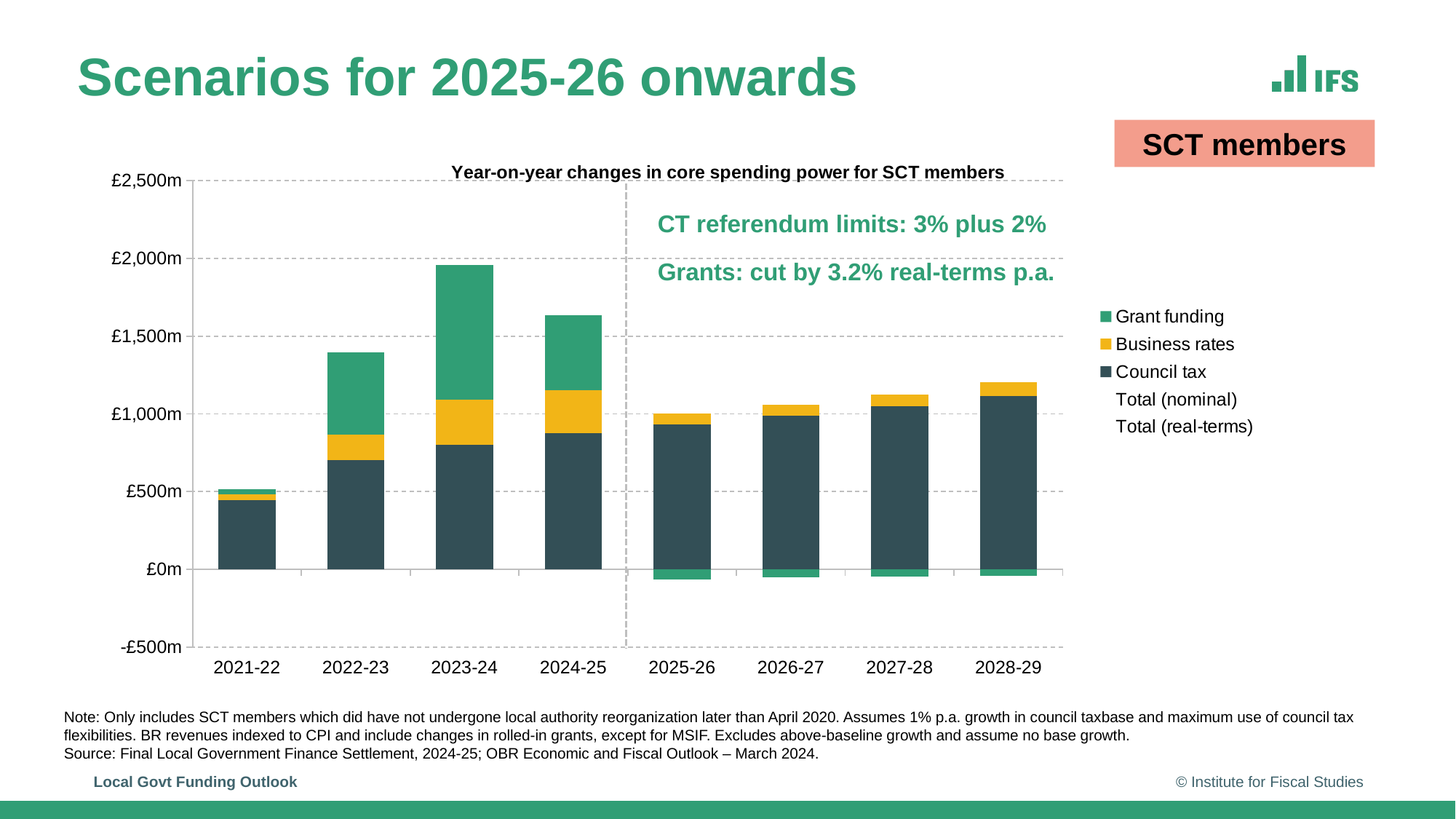
What kind of chart is shown on the slide? Stacked bar chart Which year has the larger Grant funding value, 2023-24 or 2024-25? 2023-24 Is the top of the stacked bar for 2023-24 greater or less than £2,000m? less Is the Council tax value for 2028-29 greater or less than £1,000m? greater Is the Grant funding value for 2026-27 greater or less than £0m? less What is the title of the chart? Year-on-year changes in core spending power for SCT members How many series does the chart's legend list? 5 Which year has the tallest stacked bar? 2023-24 From 2025-26 to 2028-29, does the Council tax value rise or fall? rise Which year has the shortest stacked bar? 2021-22 How many years (categories) are shown on the x axis? 8